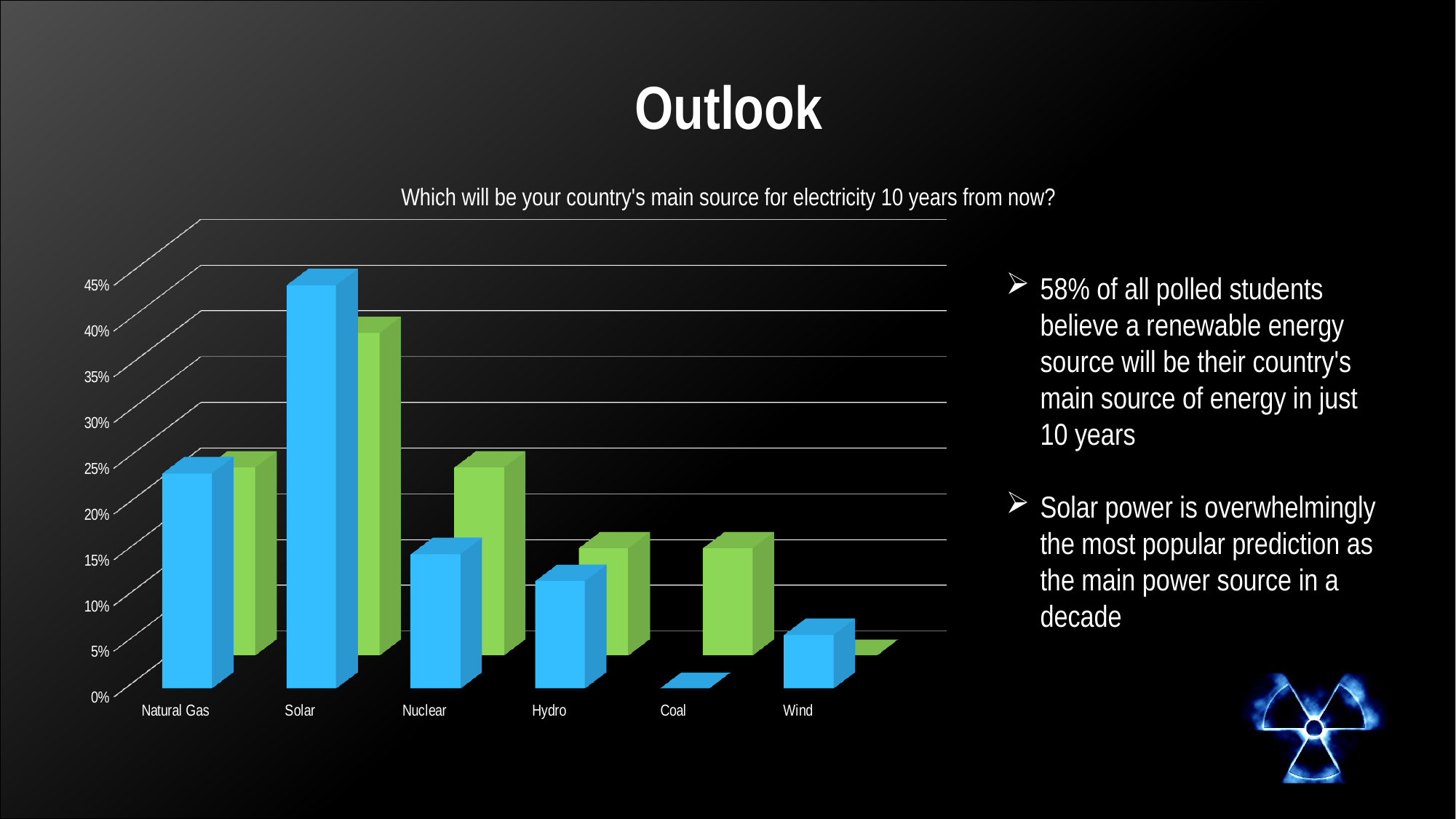
Which category has the tallest green bar in the chart? Solar Is the value of the blue bar for Solar greater or less than 40%? greater Which blue bar is taller, Natural Gas or Hydro? Natural Gas Which category has the tallest blue bar in the chart? Solar How many energy source categories are shown on the x axis of the chart? 6 Is the value of the blue bar for Wind greater or less than 10%? less Which category has the lowest blue bar in the chart? Coal For Nuclear, which bar is taller, the blue bar or the green bar? green bar What is the title of the chart? Which will be your country's main source for electricity 10 years from now? How many bars are shown for each category in the chart? 2 What kind of chart is shown on the slide? bar chart